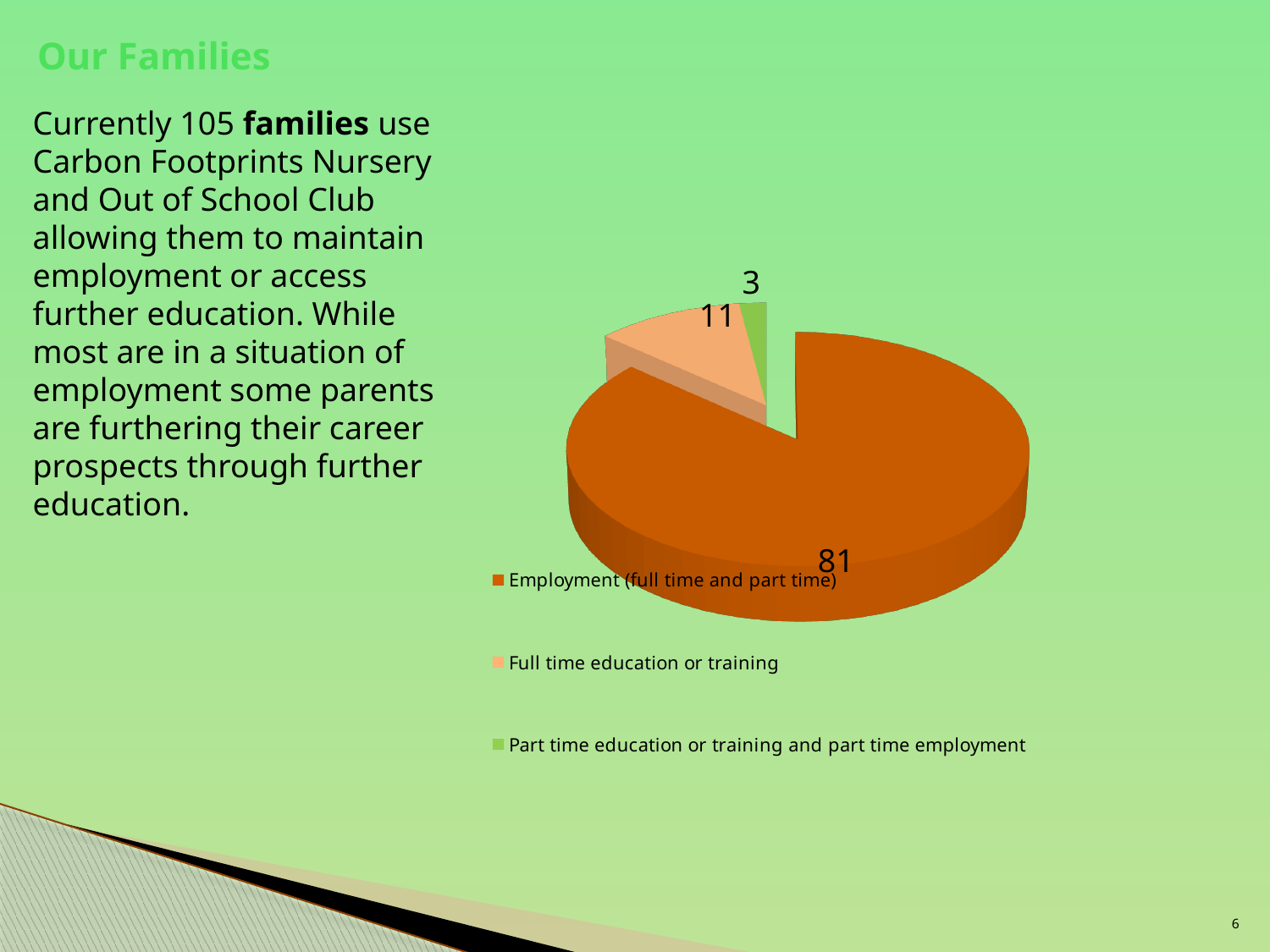
What is the difference between the values for Employment (full time and part time) and Full time education or training? 70 Which is larger, the value for Full time education or training or the value for Part time education or training and part time employment? Full time education or training What is the difference between the values for Full time education or training and Part time education or training and part time employment? 8 What kind of chart is shown on the slide? pie chart How many slices does the pie chart have? 3 Which category has the smallest slice of the pie? Part time education or training and part time employment What is the total of all the values shown on the pie chart? 95 How many entries does the legend list? 3 Which category has the largest slice of the pie? Employment (full time and part time) What is the value for Full time education or training? 11 What is the value for Part time education or training and part time employment? 3 What is the value for Employment (full time and part time)? 81